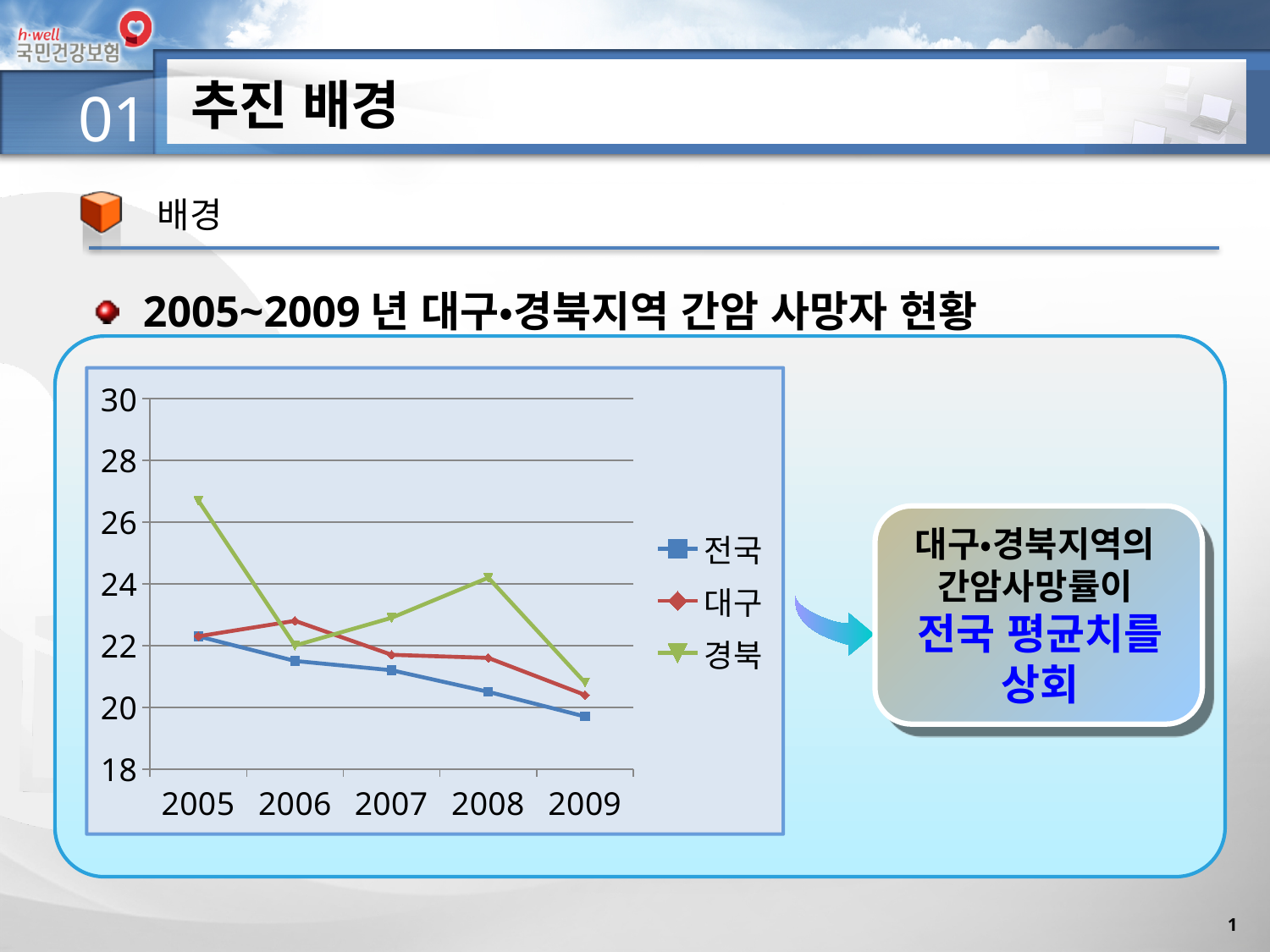
How many years are plotted along the x axis of the chart? 5 Is the value for 전국 in 2009 greater or less than 20? less How many series does the chart legend list? 3 Does the 전국 series rise or fall from 2005 to 2009? fall Is the value for 경북 in 2005 greater or less than 26? greater What kind of chart is shown on the slide? line chart In which year does the 경북 series reach its highest value? 2005 In which year does the 전국 series reach its lowest value? 2009 In 2008, which series has the larger value, 경북 or 대구? 경북 Is the value for 대구 in 2006 greater or less than 22? greater What are the three entries listed in the chart legend? 전국, 대구, 경북 Which series has the highest value in 2005? 경북